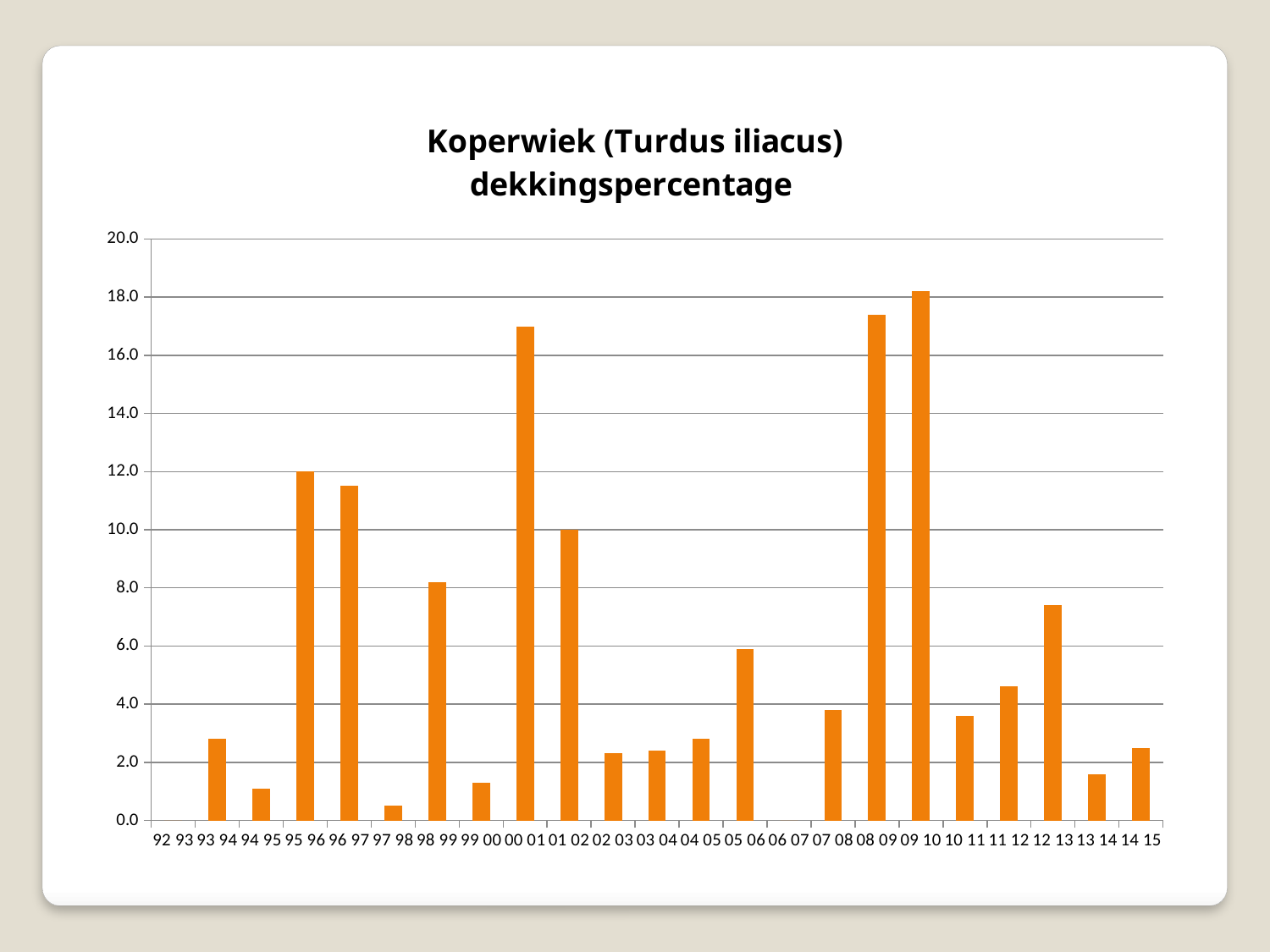
Is the value for season 13 14 greater or less than 2.0? less What kind of chart is shown on the slide? bar chart What is the value for season 01 02? 10.0 What colour are the bars in the chart? orange Is the value for season 00 01 greater or less than 16.0? greater What is the value for season 95 96? 12.0 Which is larger, the value for season 12 13 or the value for season 05 06? 12 13 What is the title of the chart? Koperwiek (Turdus iliacus) dekkingspercentage Which season has the highest bar? 09 10 Is the value for season 10 11 greater or less than 4.0? less How many seasons are listed along the x axis? 23 Which is larger, the value for season 09 10 or the value for season 00 01? 09 10